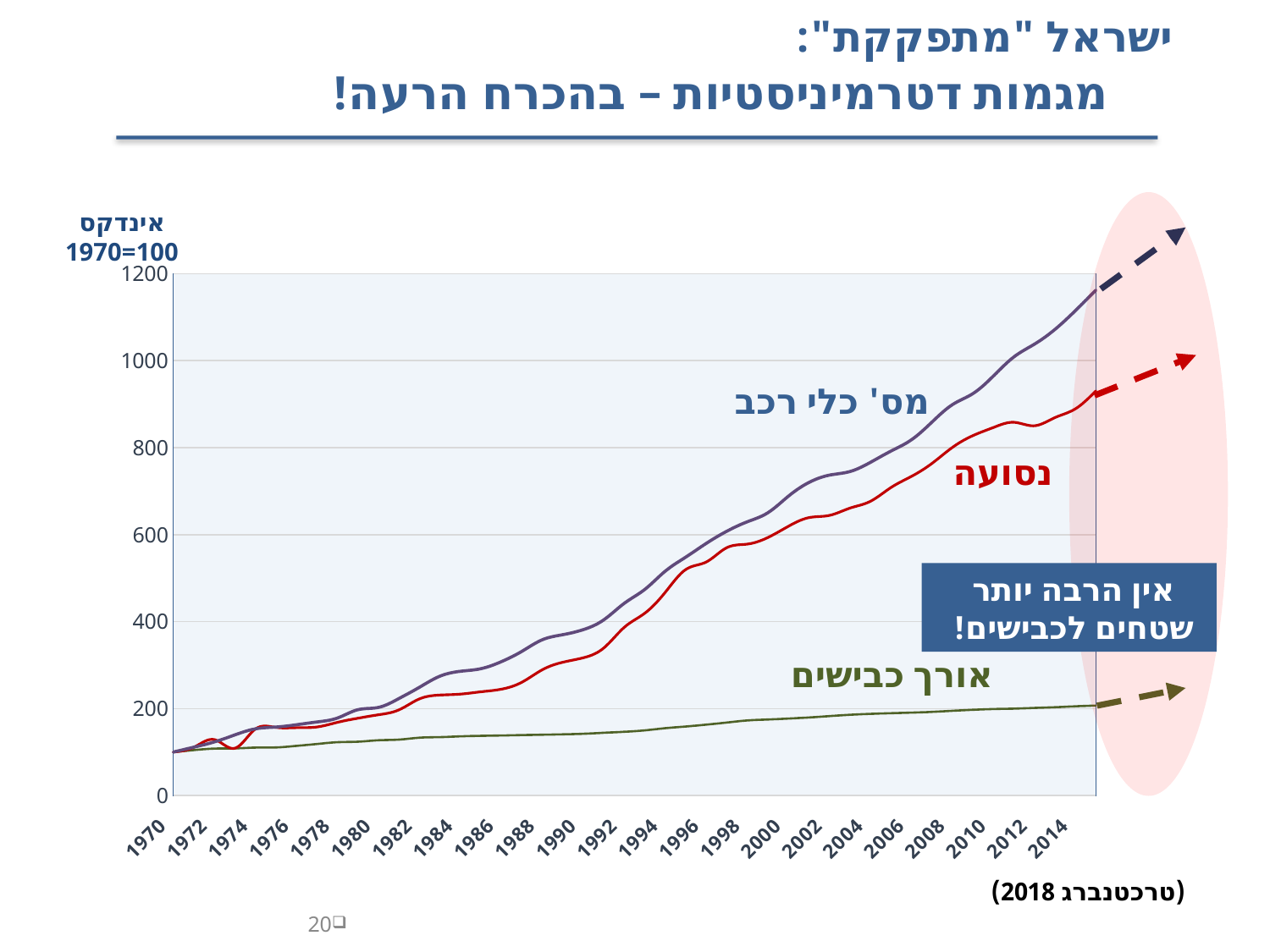
Which series has the lowest value at the right end of the chart (around 2014)? אורך כבישים How many year labels are shown on the x axis? 23 What kind of chart is shown on the slide? line chart Is the value for אורך כבישים in 2014 greater or less than 400? less Is the value for מס' כלי רכב in 2014 greater or less than 1000? greater Do the values of the מס' כלי רכב series rise or fall from 1970 to 2014? rise In 2010, which series is larger: מס' כלי רכב or נסועה? מס' כלי רכב Is the value for נסועה in 2014 greater or less than 1000? less How many data series are plotted on the chart? 3 Which series has the highest value at the right end of the chart (around 2014)? מס' כלי רכב What base year and value does the index on the y axis use? 1970=100